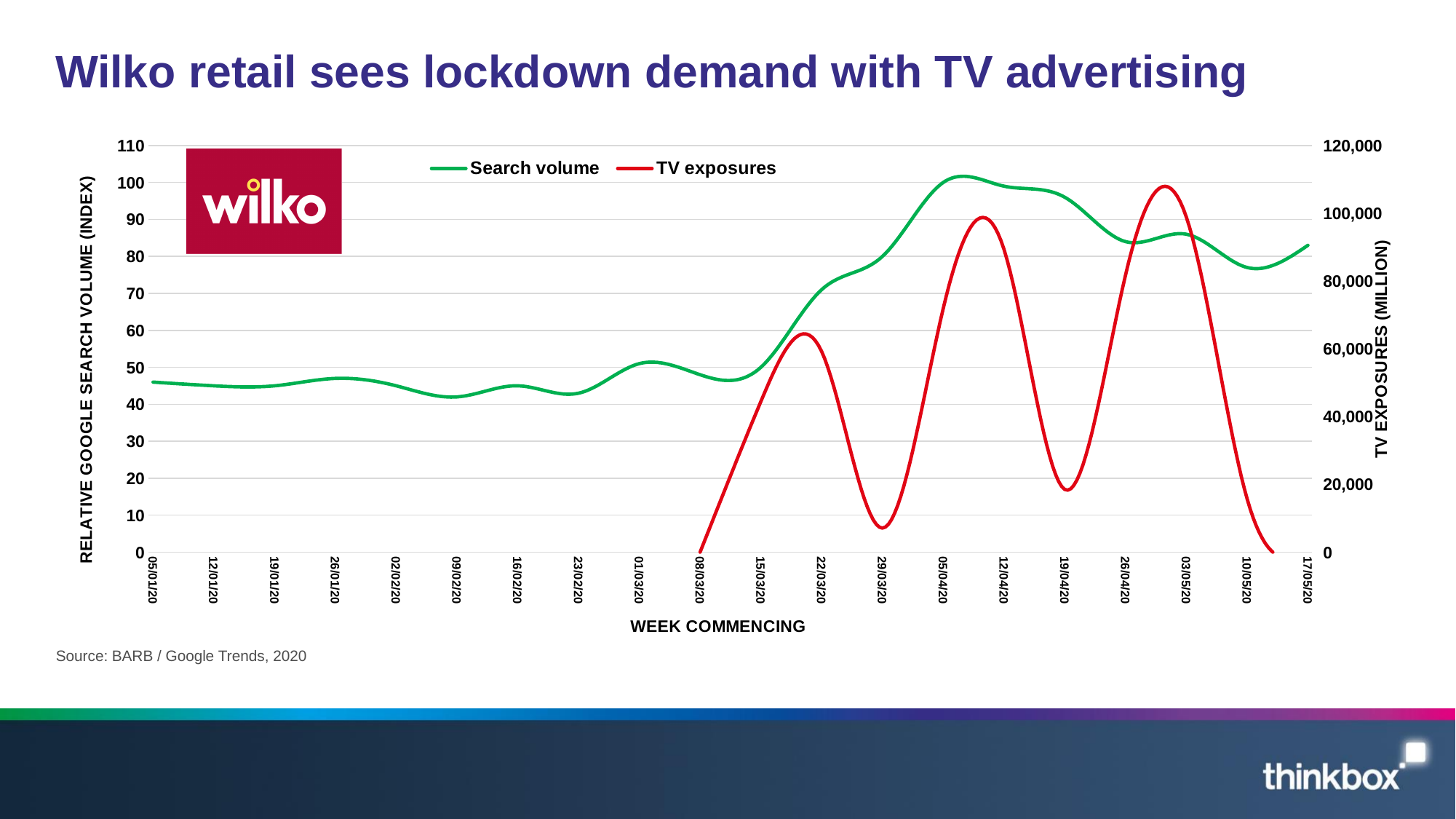
Is the TV exposures value for the week commencing 12/04/20 greater or less than 80,000? greater Which is larger: the search volume for the week commencing 05/01/20 or for the week commencing 05/04/20? 05/04/20 What is the value of TV exposures for the week commencing 08/03/20? 0 How many week-commencing dates are shown on the x axis? 20 Does the search volume rise or fall between the weeks commencing 08/03/20 and 05/04/20? Rise What kind of chart is shown on the slide? Line chart Is the search volume for the week commencing 05/01/20 greater or less than 50? less Is the search volume for the week commencing 05/04/20 greater or less than 90? greater How many series does the chart legend list? 2 What colour is the TV exposures line in the chart? Red